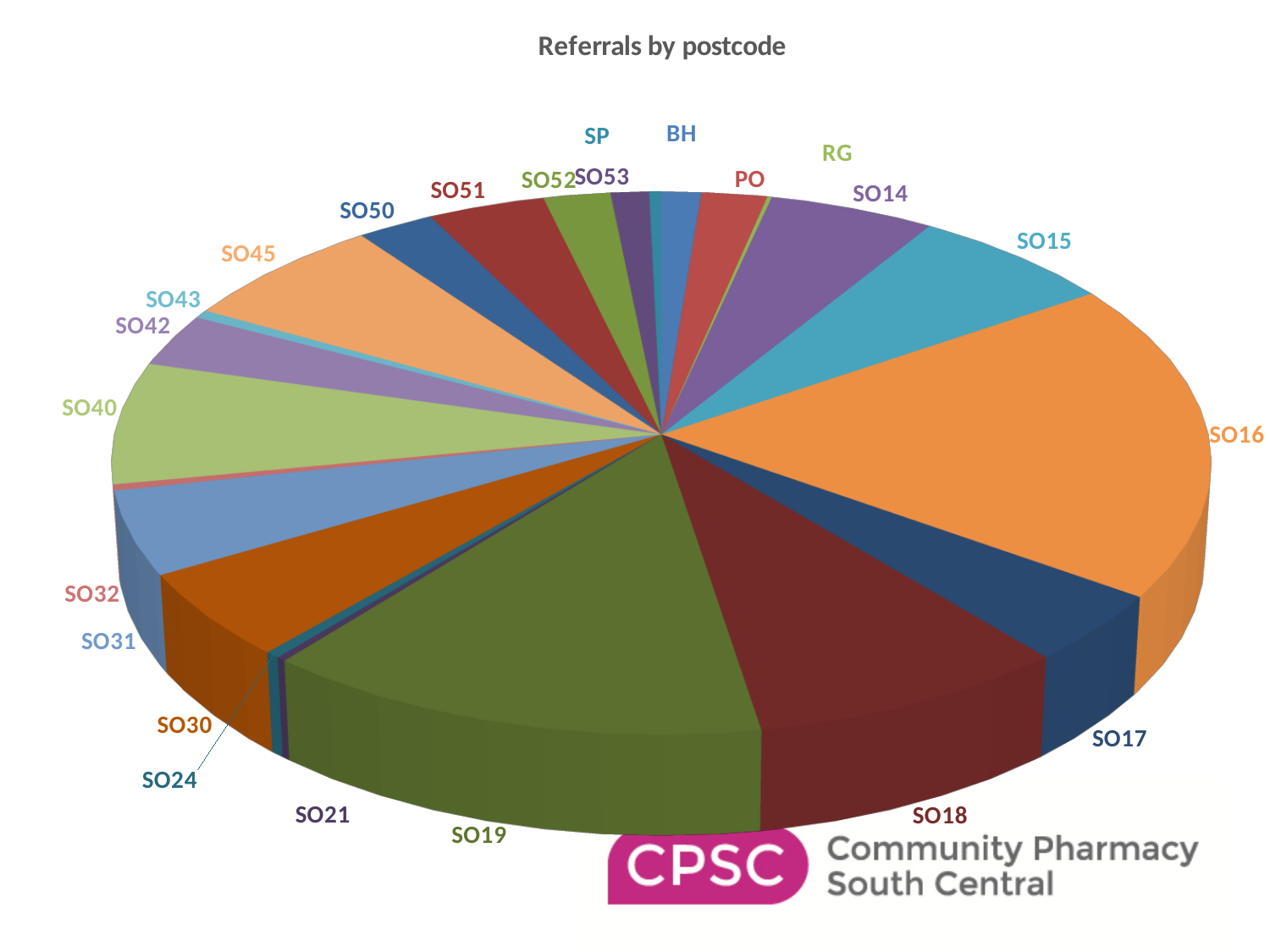
Which slice is larger, SO40 or SO32? SO40 Which slice is larger, SO16 or SO43? SO16 What is the title of the chart? Referrals by postcode Which slice is larger, SO17 or PO? SO17 How many postcode slices are labelled on the pie chart? 23 What colour is the slice labelled SO16? orange What kind of chart is shown on the slide? pie chart